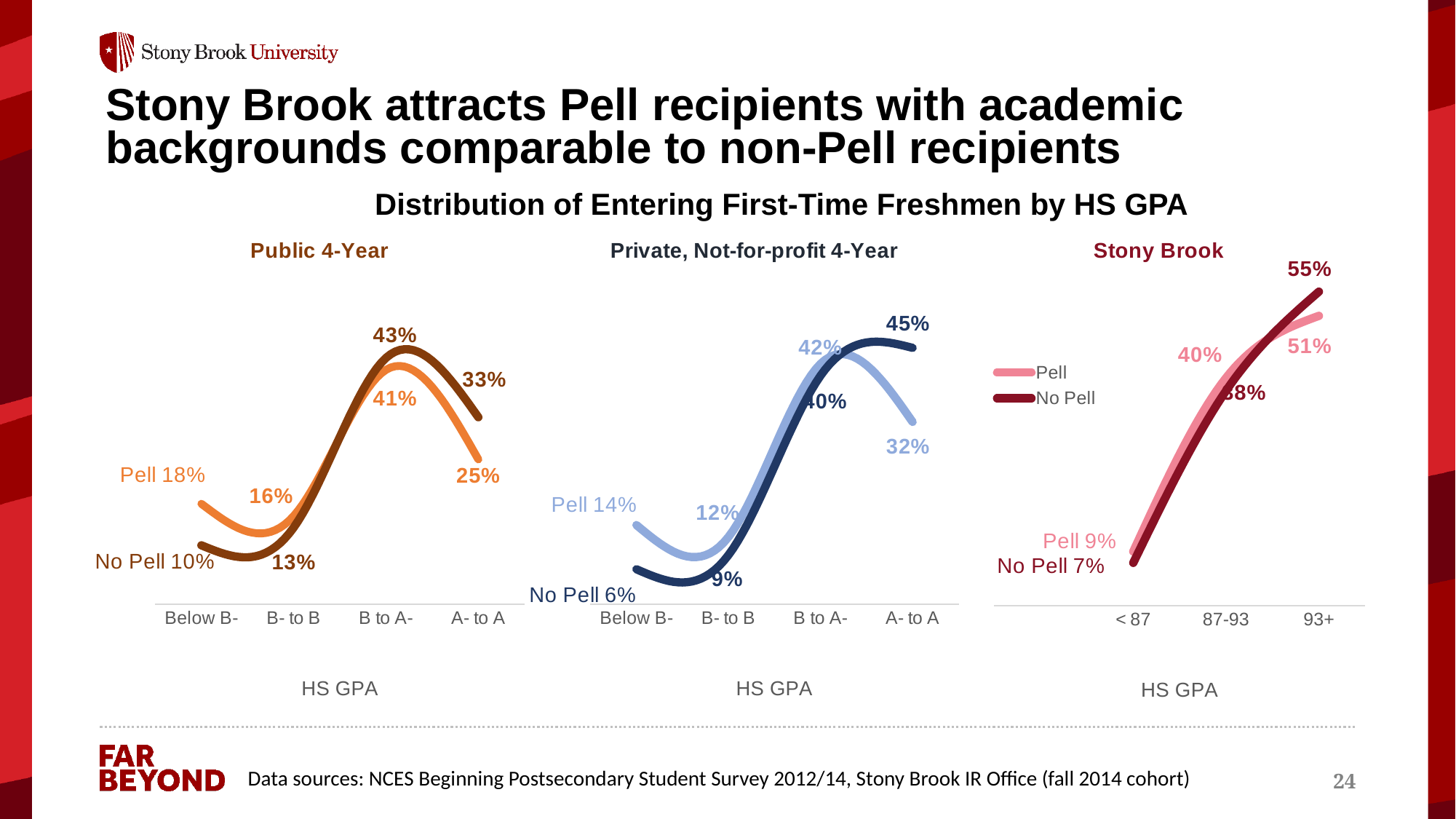
In the Private, Not-for-profit 4-Year chart, which is larger for the A- to A category, the Pell value or the No Pell value? No Pell In the Private, Not-for-profit 4-Year chart, which HS GPA category has the lowest Pell value? B- to B What type of chart is the Public 4-Year chart? Line chart In the Private, Not-for-profit 4-Year chart, what is the No Pell value for Below B-? 6% How many HS GPA categories are shown on the x axis of the Stony Brook chart? 3 In the Stony Brook chart, what percentage of No Pell students had a HS GPA of 93+? 55% In the Public 4-Year chart, which HS GPA category has the highest No Pell value? B to A- In the Public 4-Year chart, what is the difference between the No Pell and Pell values for the B to A- category? 2% In the Public 4-Year chart, what percentage of Pell recipients had a HS GPA of B to A-? 41% In the Stony Brook chart, what is the Pell value for the 93+ category? 51% How many series does the legend in the Stony Brook chart list? 2 In the Public 4-Year chart, what is the No Pell value for the A- to A category? 33%